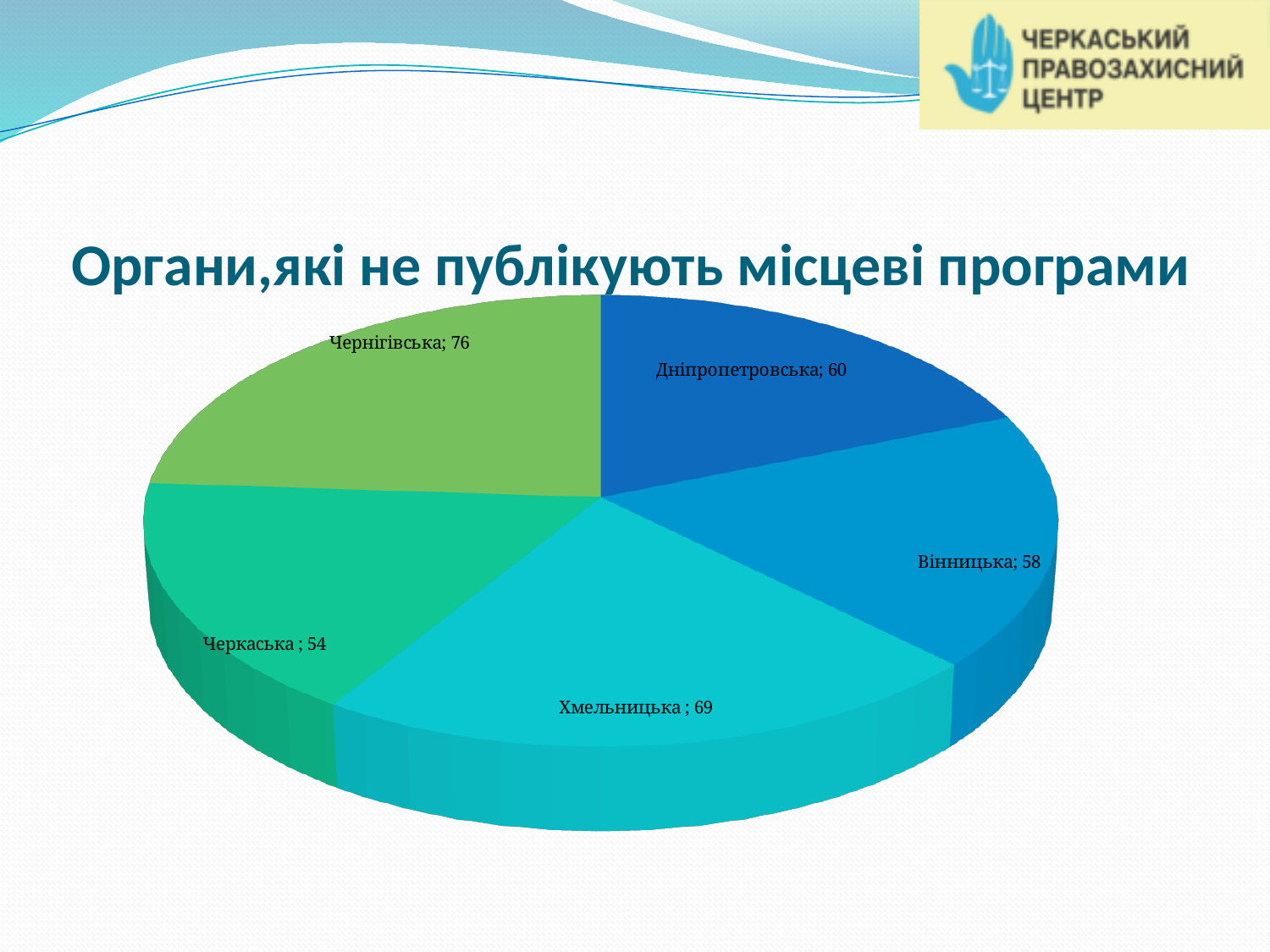
What value is shown for Вінницька in the pie chart? 58 Which has the larger value, Дніпропетровська or Вінницька? Дніпропетровська What is the difference between the values for Хмельницька and Дніпропетровська? 9 What type of chart is shown on the slide? Pie chart What is the difference between the values for Чернігівська and Черкаська? 22 How many regions (slices) are shown in the pie chart? 5 Which region has the smallest slice in the pie chart? Черкаська What value is shown for Черкаська in the pie chart? 54 What is the title of the chart on the slide? Органи,які не публікують місцеві програми Which region has the largest slice in the pie chart? Чернігівська What value is shown for Чернігівська in the pie chart? 76 What value is shown for Хмельницька in the pie chart? 69